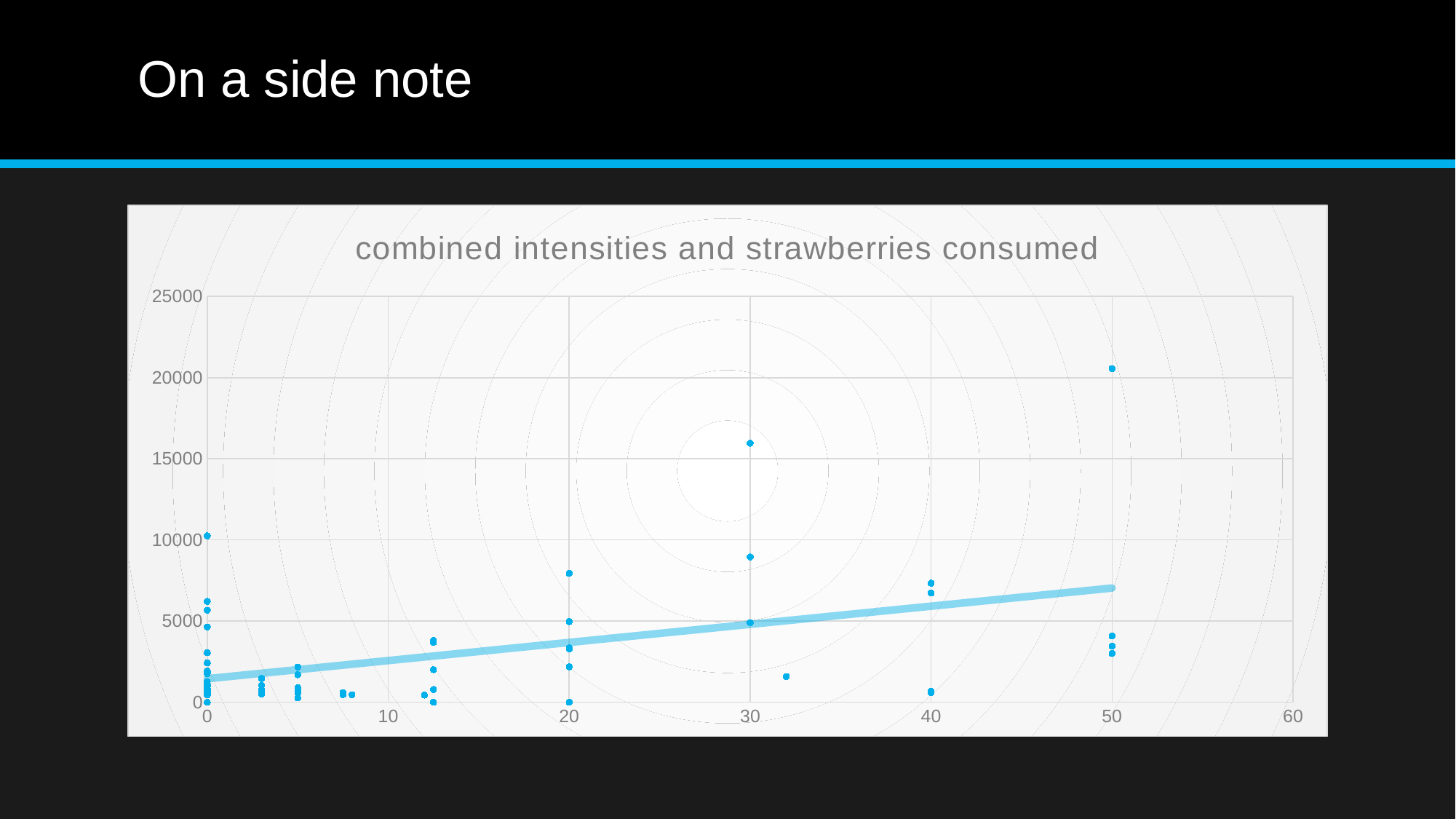
At which x-axis value is the highest plotted point located? 50 Which has a higher maximum plotted value: the points at x = 30 or the points at x = 40? x = 30 Does the trend line on the chart rise or fall as the x-axis value increases? rise Is the highest plotted point on the chart greater or less than 20000? greater Is the trend line value at x = 50 greater or less than 10000? less Is the highest point at x = 0 greater or less than 5000? greater What is the title of the chart? combined intensities and strawberries consumed What is the maximum value shown on the y-axis? 25000 What kind of chart is shown on the slide? scatter chart